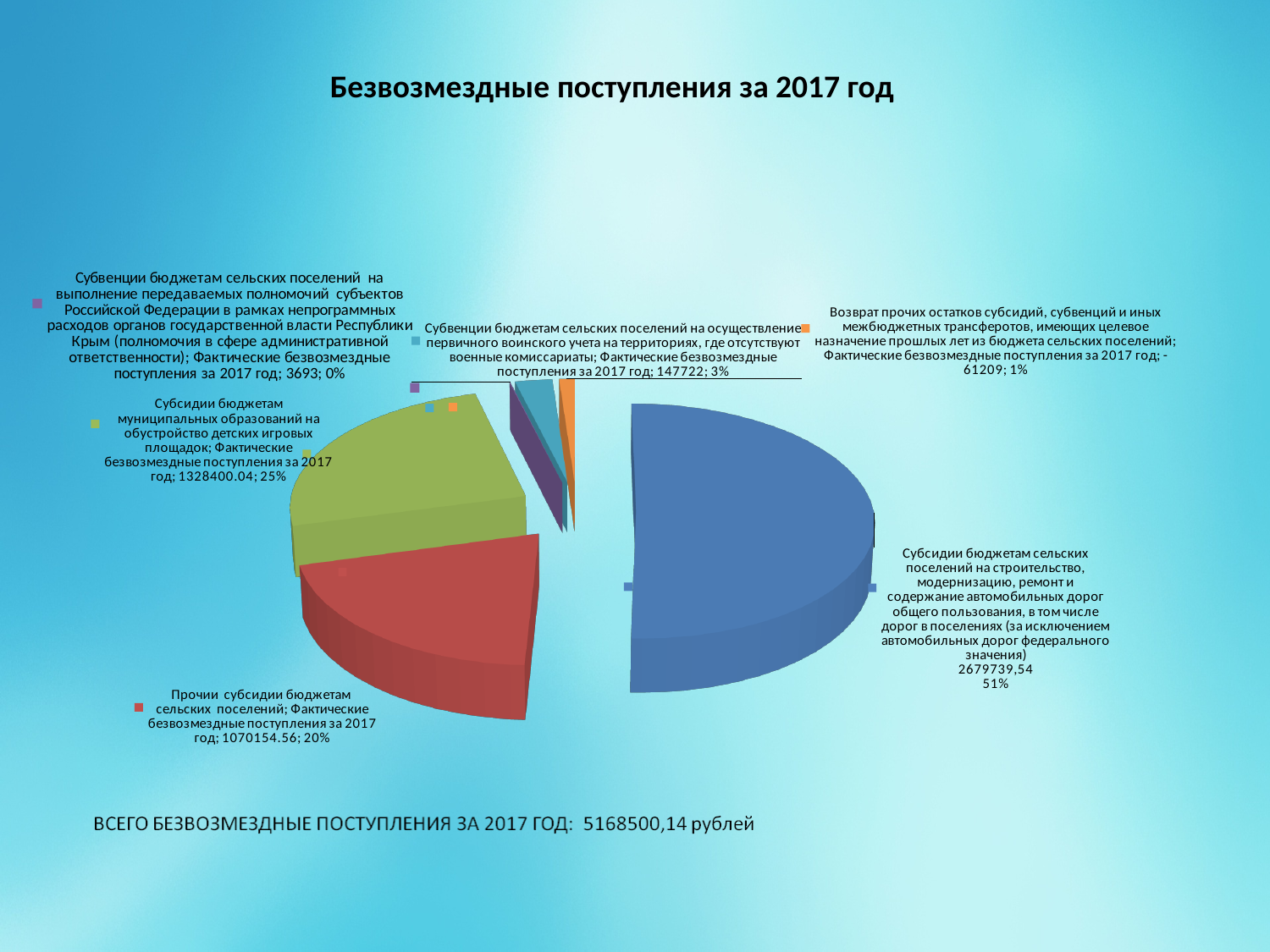
What is the value for 'Субвенции бюджетам сельских поселений на осуществление первичного воинского учета'? 147722 How many slices does the pie chart have? 6 What is the title of the chart? Безвозмездные поступления за 2017 год What kind of chart is shown on the slide? pie chart What is the value for 'Прочии субсидии бюджетам сельских поселений'? 1070154.56 Which is larger: 'Прочии субсидии бюджетам сельских поселений' or 'Субсидии бюджетам муниципальных образований на обустройство детских игровых площадок'? Субсидии бюджетам муниципальных образований на обустройство детских игровых площадок What is the value for 'Субвенции бюджетам сельских поселений на выполнение передаваемых полномочий субъектов Российской Федерации'? 3693 What share of the pie is the slice for subsidies for roads (Субсидии бюджетам сельских поселений на строительство, модернизацию, ремонт и содержание автомобильных дорог)? 51% What is the total of all gratuitous receipts for 2017 stated on the slide? 5168500,14 рублей What share of the pie is 'Субсидии бюджетам муниципальных образований на обустройство детских игровых площадок'? 25% Which category has the largest slice of the pie? Субсидии бюджетам сельских поселений на строительство, модернизацию, ремонт и содержание автомобильных дорог общего пользования What is the value for 'Возврат прочих остатков субсидий, субвенций и иных межбюджетных трансферотов'? -61209